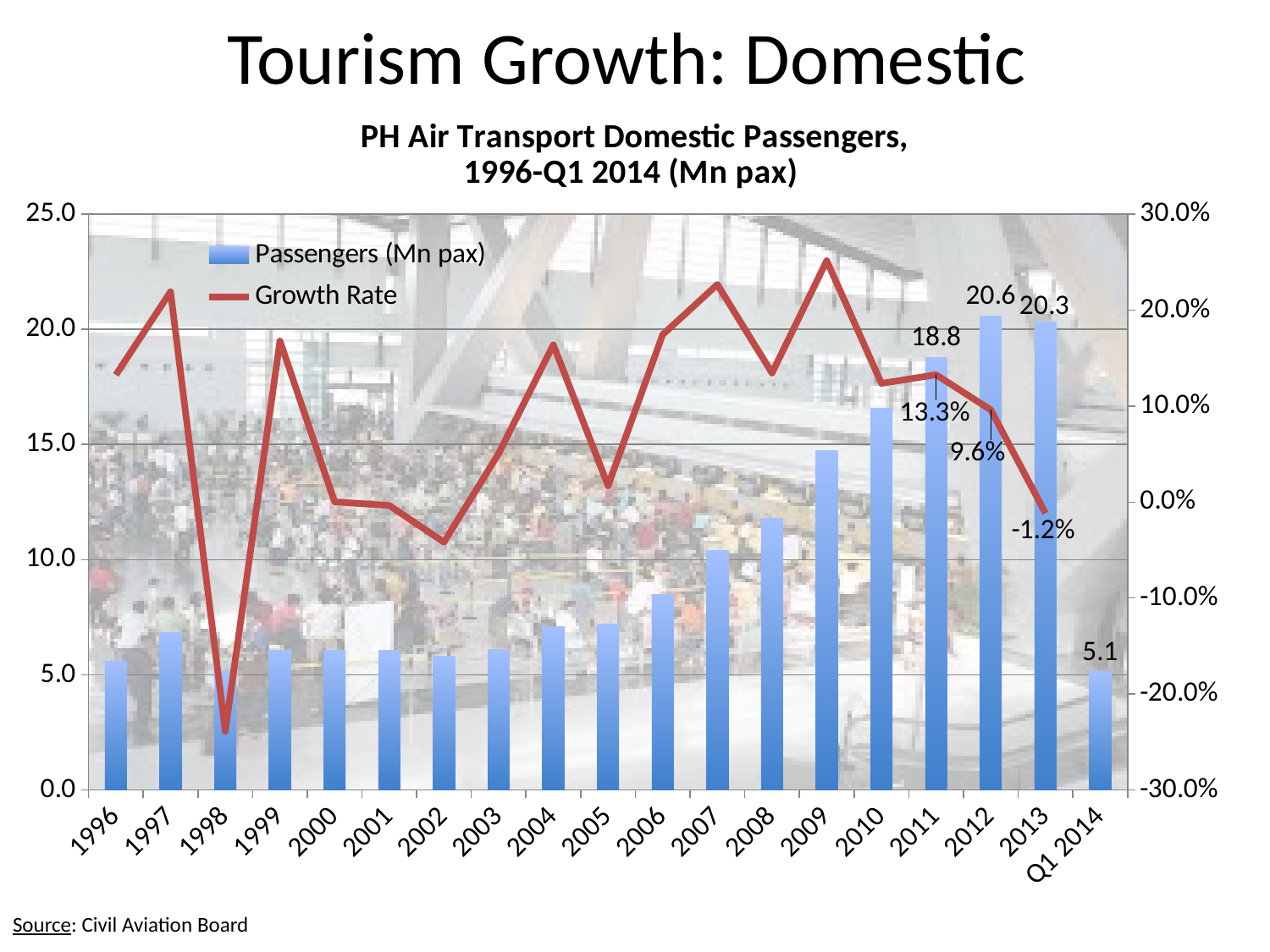
Which year has the lowest growth rate? 1998 Which year has more passengers, 2011 or 2013? 2013 What is the passenger value labelled for Q1 2014? 5.1 Do the passenger bars rise or fall from 2005 to 2012? rise How many categories are shown on the x axis? 19 How many series does the legend list? 2 Which year has the highest number of passengers? 2012 What is the difference in passengers (Mn pax) between 2012 and 2013? 0.3 What is the number of passengers (Mn pax) for 2012? 20.6 Is the passenger value for 2010 greater or less than 15.0? greater What is the growth rate shown for 2013? -1.2% What is the growth rate shown for 2011? 13.3%